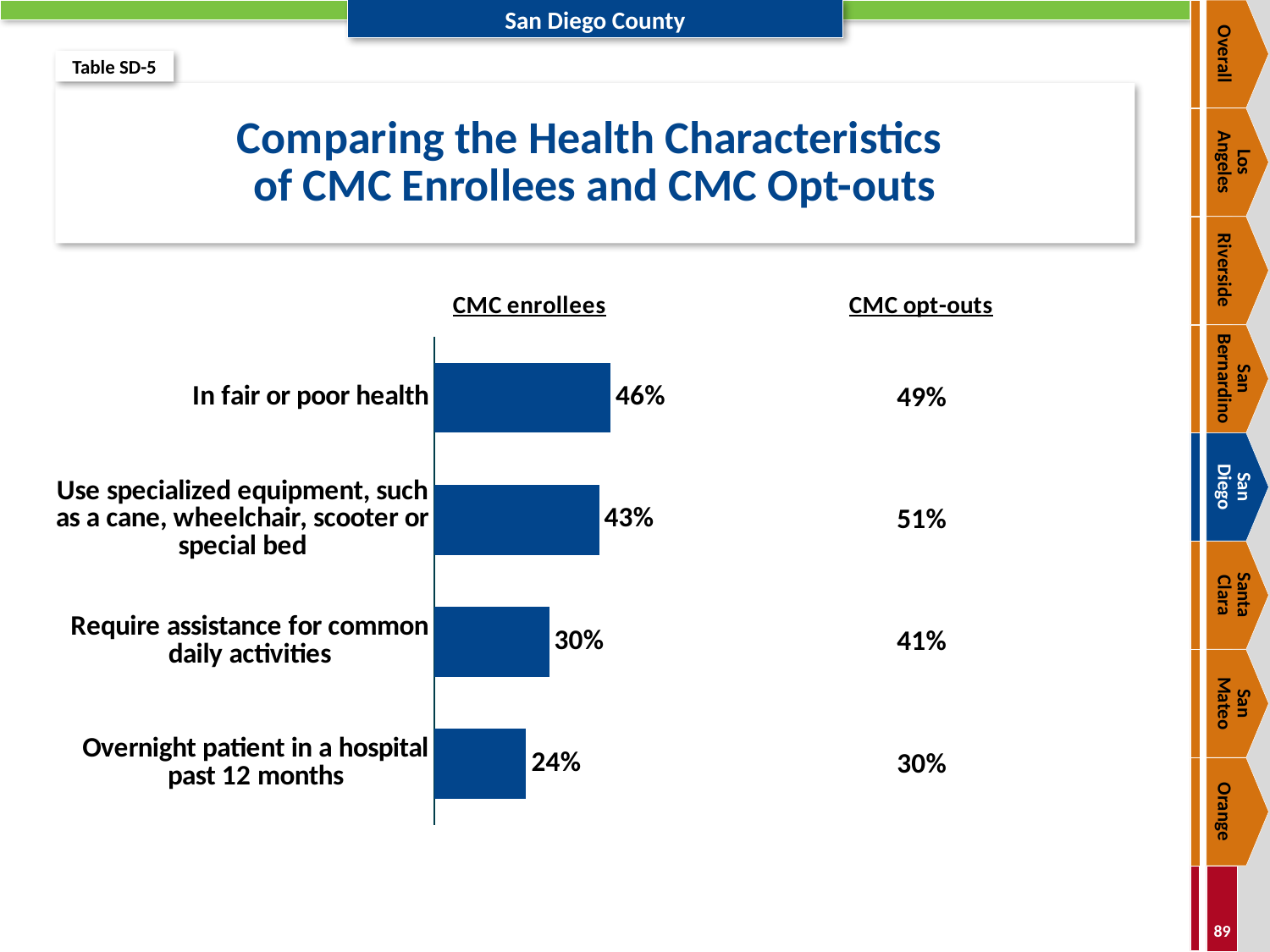
What is the difference between the CMC enrollees values for "In fair or poor health" and "Overnight patient in a hospital past 12 months"? 22% What is the difference between the CMC opt-outs and CMC enrollees values for "Require assistance for common daily activities"? 11% Which category has the lowest CMC enrollees value? Overnight patient in a hospital past 12 months What kind of chart is used to show the CMC enrollees values? Bar chart What is the title of the chart? Comparing the Health Characteristics of CMC Enrollees and CMC Opt-outs How many categories are shown in the chart? 4 What is the CMC enrollees value for "Overnight patient in a hospital past 12 months"? 24% What is the CMC enrollees value for "Require assistance for common daily activities"? 30% What is the CMC opt-outs value for "Use specialized equipment, such as a cane, wheelchair, scooter or special bed"? 51% For "In fair or poor health", which group has the larger value, CMC enrollees or CMC opt-outs? CMC opt-outs Which category has the highest CMC enrollees value? In fair or poor health What is the CMC enrollees value for "In fair or poor health"? 46%